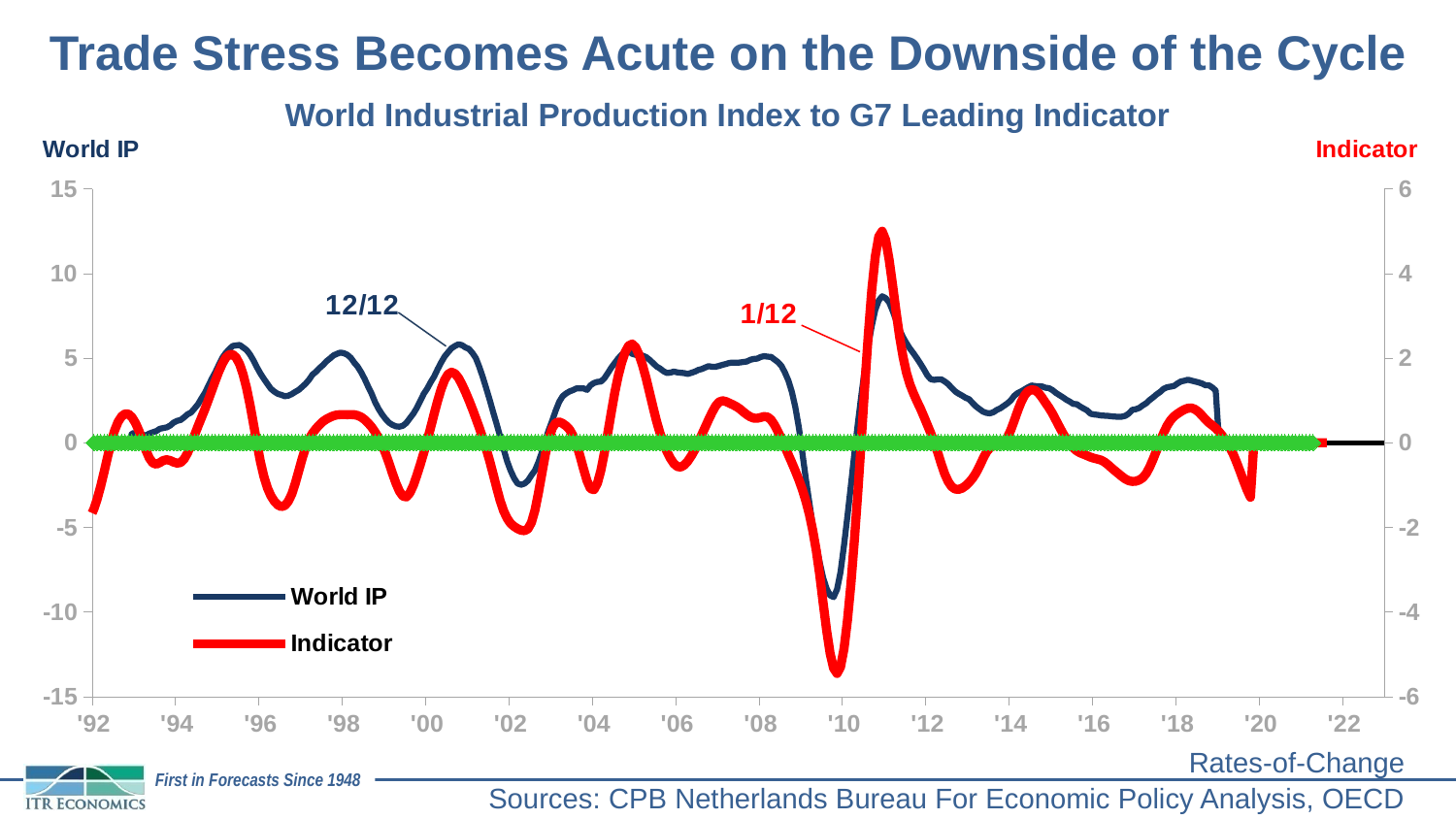
What kind of chart is shown on the slide? line chart What are the two series named in the legend? World IP and Indicator Does the World IP series rise or fall between '18 and '19? fall Around which year does the Indicator series reach its highest value? 2011 Which is larger: the World IP peak around 2011 or the World IP peak around 1995? the peak around 2011 What is the chart's subtitle describing the data plotted? World Industrial Production Index to G7 Leading Indicator Is the World IP value at its 2010 trough greater or less than -5? less Is the Indicator value at its 2011 peak greater or less than 4 on the right axis? greater Around which year does the World IP series reach its highest value? 2011 Around which year does the World IP series reach its lowest value? 2009 How many series does the legend list? 2 How many year labels are shown along the x axis? 16